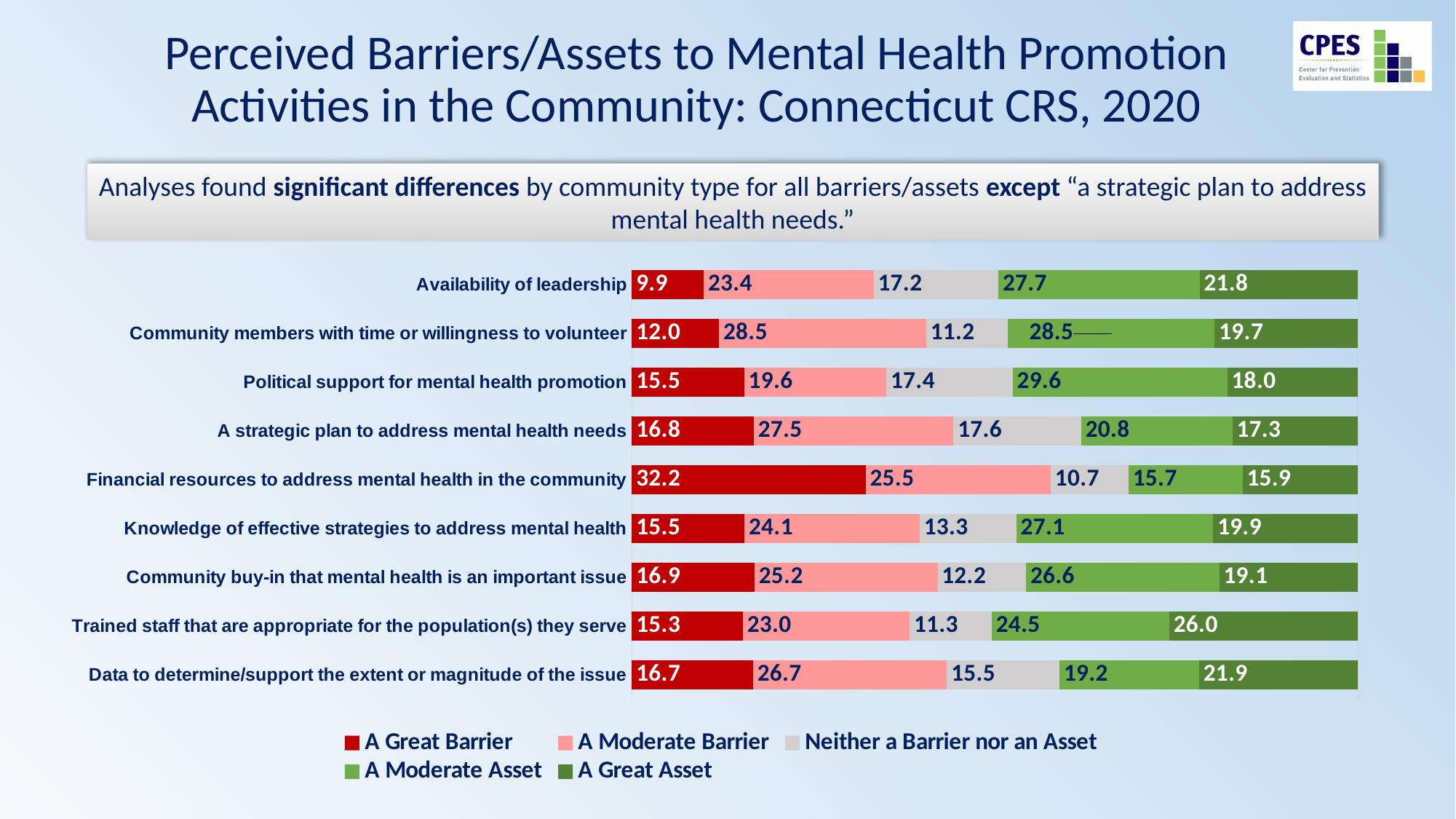
What is the value for "Neither a Barrier nor an Asset" for "Community members with time or willingness to volunteer"? 11.2 What is the total of the stacked bar for "Availability of leadership"? 100.0 What is the value for "A Great Barrier" for "Financial resources to address mental health in the community"? 32.2 How many series does the legend list? 5 What is the value for "A Great Asset" for "Trained staff that are appropriate for the population(s) they serve"? 26.0 Which category has the lowest value for "A Great Barrier"? Availability of leadership What is the difference between the "A Moderate Asset" values for "Political support for mental health promotion" and "A strategic plan to address mental health needs"? 8.8 Which category has the highest value for "A Moderate Asset"? Political support for mental health promotion Which has the larger "A Great Asset" value: "Trained staff that are appropriate for the population(s) they serve" or "Data to determine/support the extent or magnitude of the issue"? Trained staff that are appropriate for the population(s) they serve How many categories (barriers/assets) are shown in the chart? 9 Which category has the highest value for "A Great Barrier"? Financial resources to address mental health in the community What kind of chart is shown on the slide? Stacked bar chart